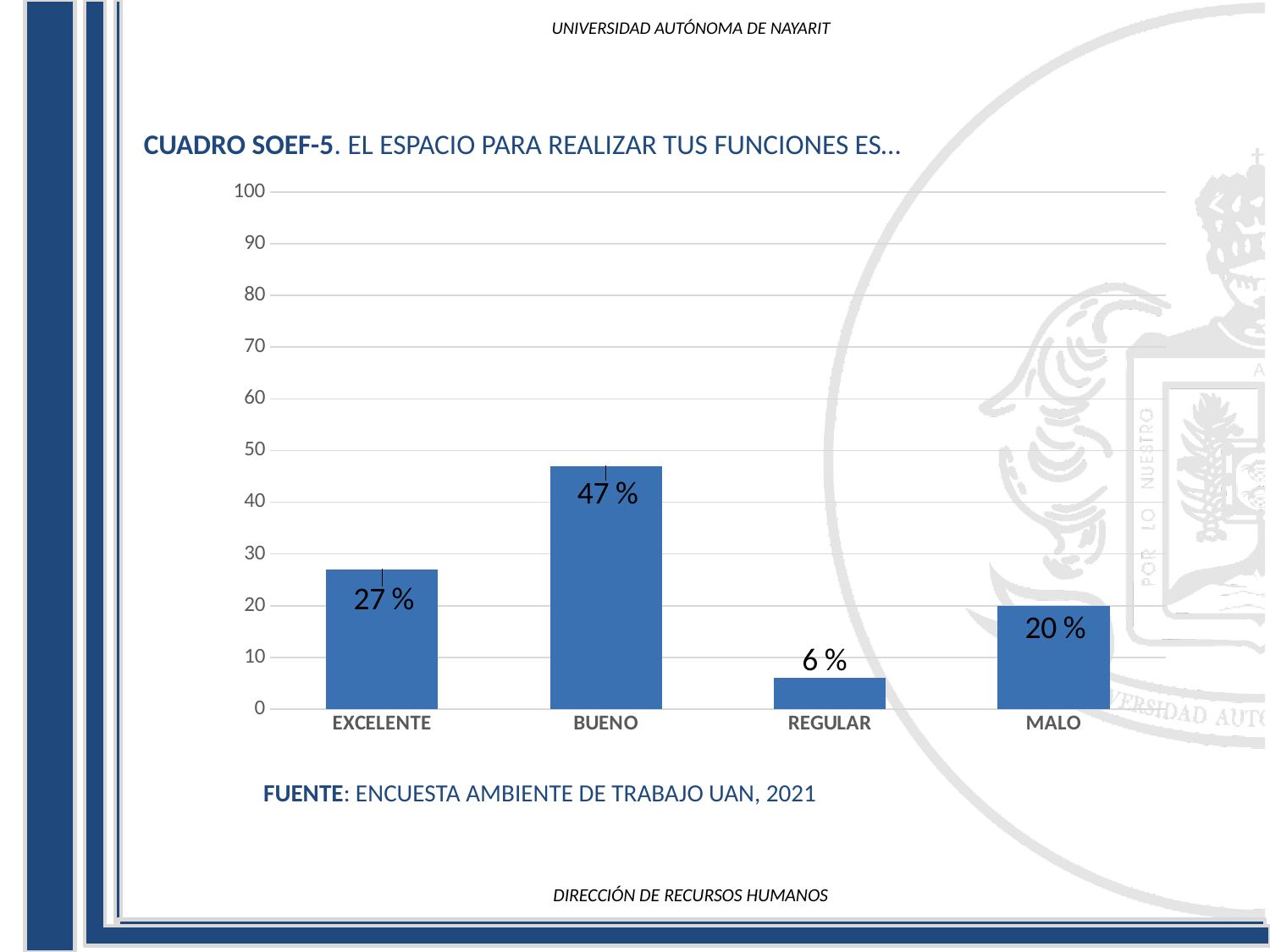
What is the value for REGULAR? 6 % What is the value for MALO? 20 % Which is larger, the value for EXCELENTE or the value for MALO? EXCELENTE What kind of chart is shown on the slide? bar chart Which category has the highest value? BUENO What is the value for EXCELENTE? 27 % Is the value for BUENO greater or less than 50? less Which category has the lowest value? REGULAR What is the value for BUENO? 47 % What source is cited below the chart? ENCUESTA AMBIENTE DE TRABAJO UAN, 2021 What is the difference between the values for BUENO and EXCELENTE? 20 % How many categories are shown on the x axis? 4